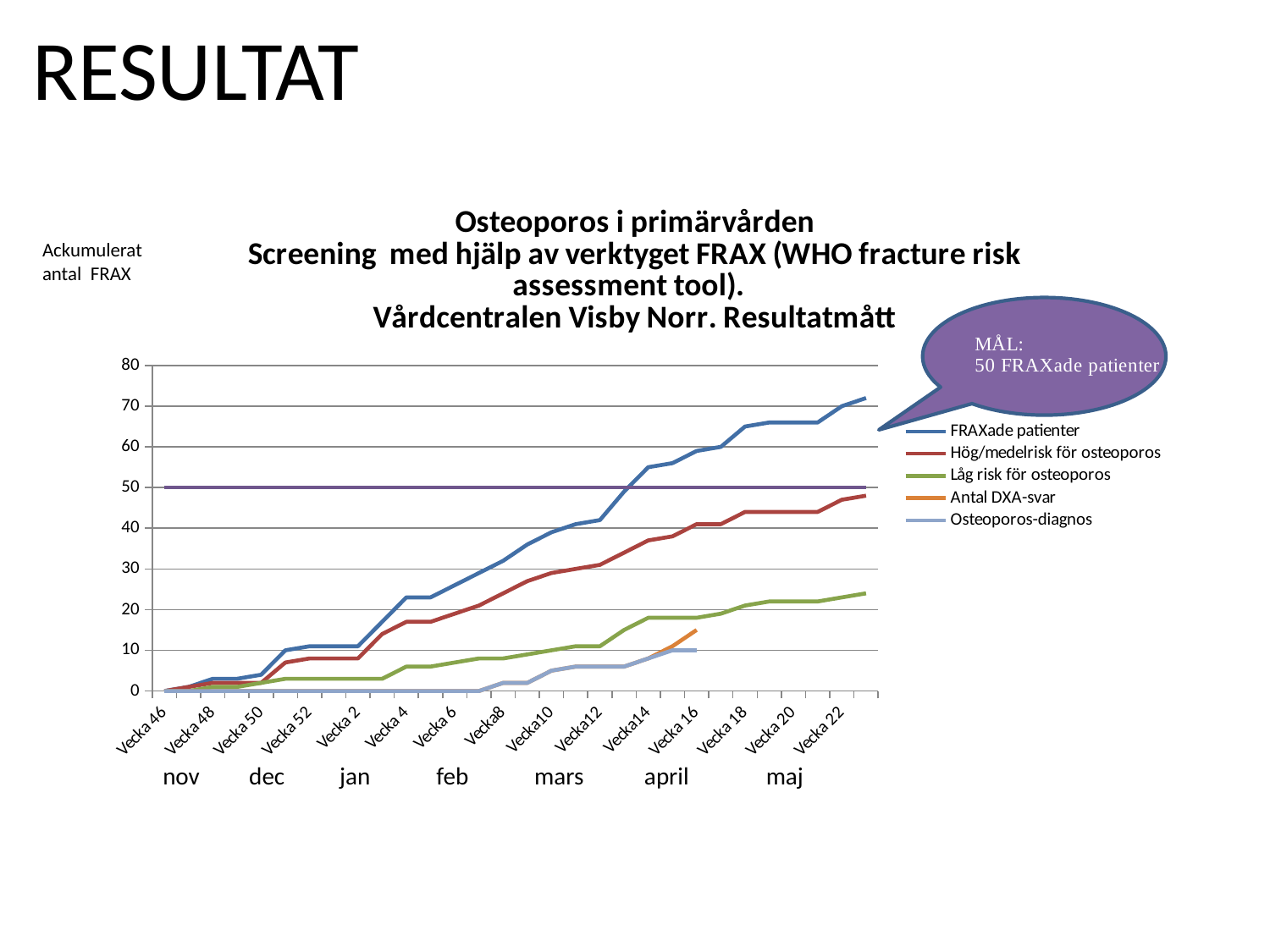
Is the final value of the Låg risk för osteoporos line greater or less than 20? greater What target (MÅL) number of FRAXade patienter is marked by the horizontal line? 50 How many series does the legend list? 5 What kind of chart is shown on the slide? line chart Which series reaches the highest value on the chart? FRAXade patienter Is the final value of the Hög/medelrisk för osteoporos line greater or less than 40? greater How many week labels are shown on the x axis? 15 Is the final value of the Antal DXA-svar line greater or less than 20? less Does the FRAXade patienter line rise or fall from Vecka 46 to Vecka 22? rise Which health centre is named in the chart title? Vårdcentralen Visby Norr At the end of the chart, which is larger: Hög/medelrisk för osteoporos or Låg risk för osteoporos? Hög/medelrisk för osteoporos